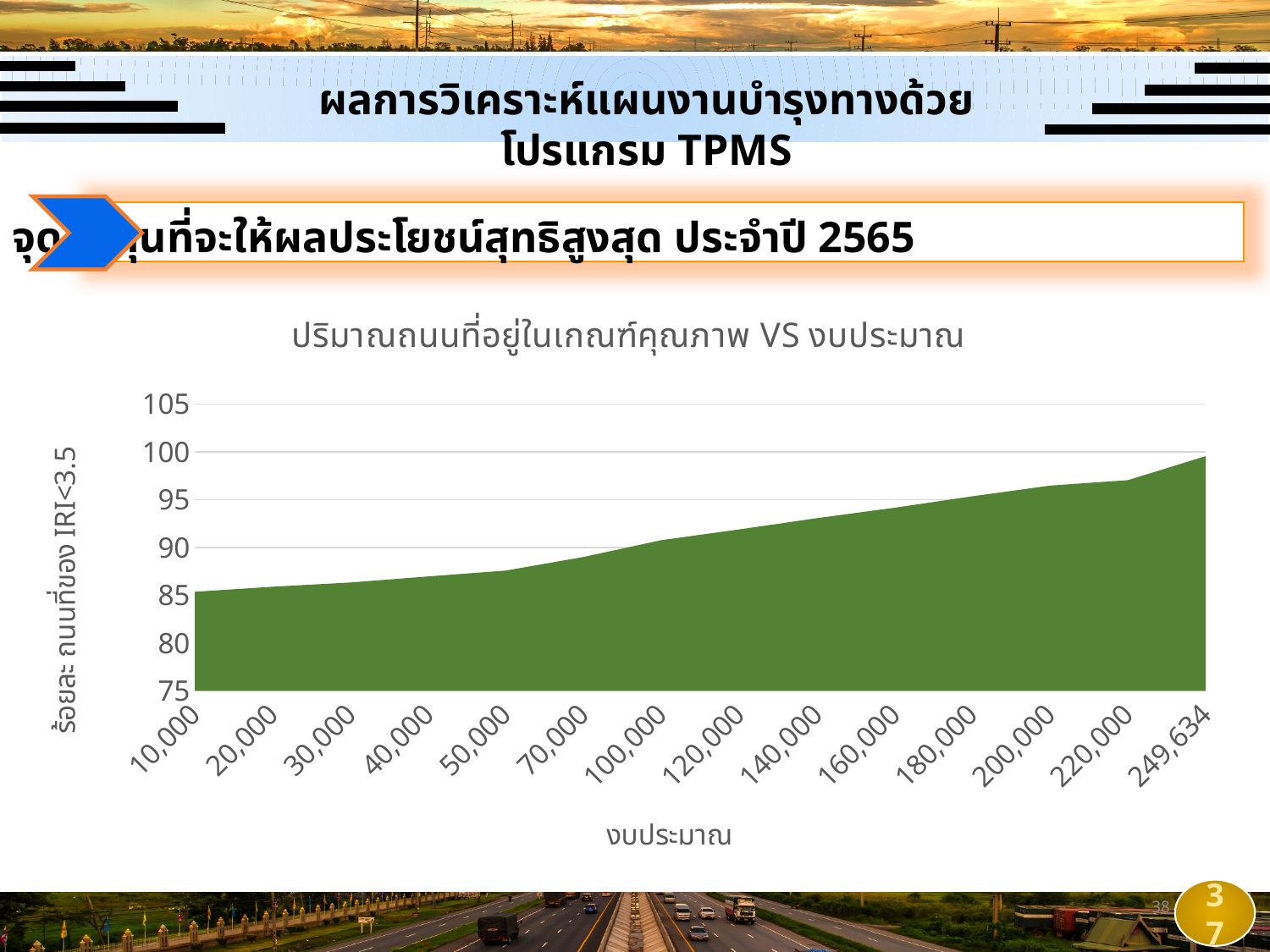
Do the values rise or fall as the budget increases along the x axis? Rise How many budget categories are shown along the x axis? 14 At which budget value is the percentage of roads with IRI<3.5 highest? 249,634 Is the value at a budget of 249,634 greater or less than 95? greater What kind of chart is shown on the slide? Area chart What is the title of the chart? ปริมาณถนนที่อยู่ในเกณฑ์คุณภาพ VS งบประมาณ Which has the larger value: a budget of 140,000 or a budget of 40,000? 140,000 What is the label of the x axis of the chart? งบประมาณ Is the value at a budget of 120,000 greater or less than 90? greater At which budget value is the percentage of roads with IRI<3.5 lowest? 10,000 Is the value at a budget of 50,000 greater or less than 90? less